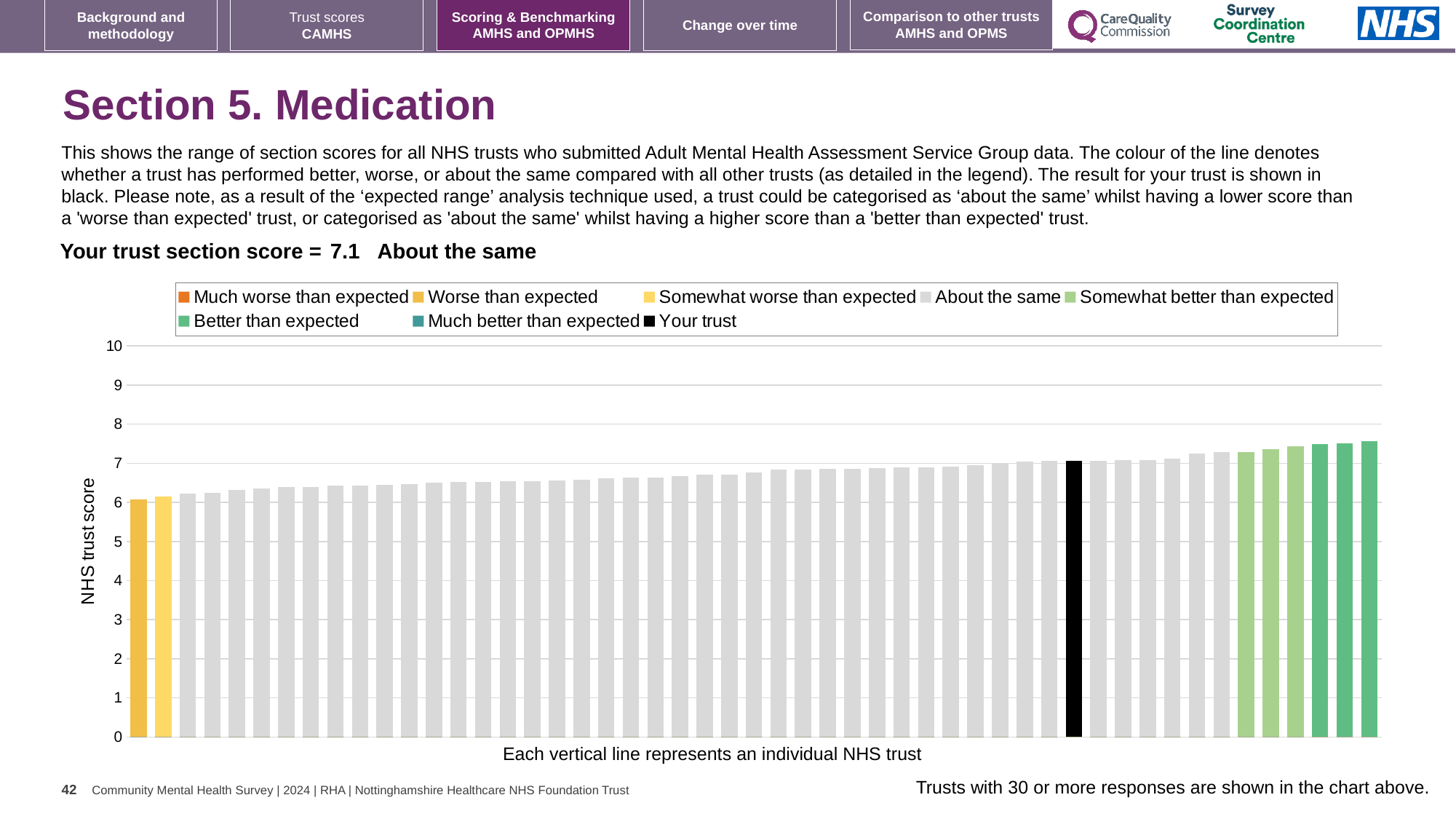
Is the value of the highest bar in the chart greater or less than 7? greater What is the section score for your trust shown on the slide? 7.1 What is the label on the y axis of the chart? NHS trust score Is the value for your trust (the black bar) greater or less than 5? greater Which category does your trust fall into according to the slide? About the same Do the bar values rise or fall from left to right along the x axis? rise How many bars are coloured as 'Better than expected' (dark green) in the chart? 3 How many entries does the chart legend list? 8 Is the value of the highest bar in the chart greater or less than 8? less What kind of chart is shown on the slide? bar chart How many bars are coloured as 'Worse than expected' (yellow) in the chart? 1